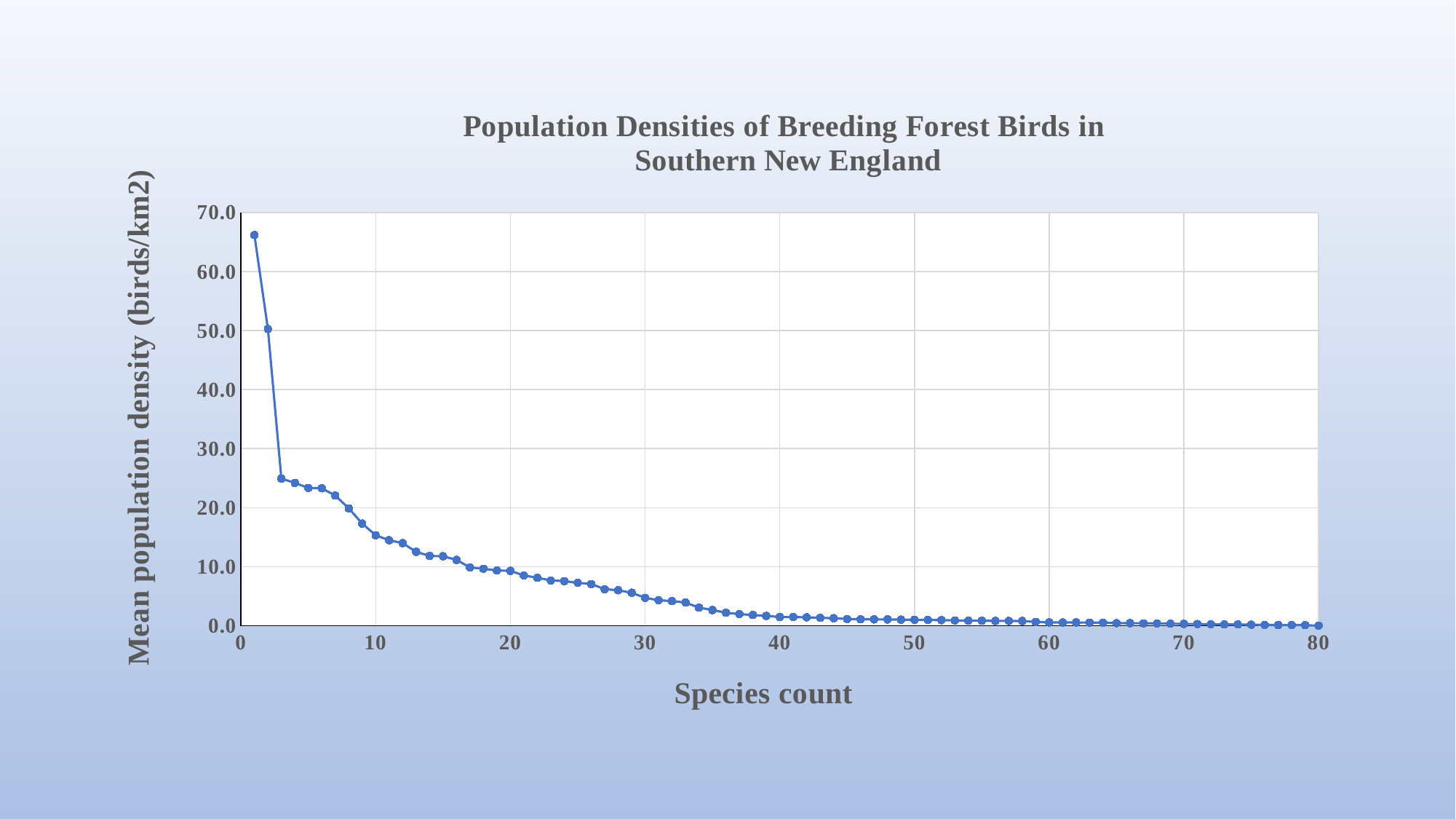
Is the mean population density at species count 3 greater or less than 20.0? greater Do the values rise or fall as species count increases along the x axis? fall What is the title of the chart? Population Densities of Breeding Forest Birds in Southern New England Is the mean population density at species count 10 greater or less than 10.0? greater How many data points are plotted on the chart? 80 At which species count is the mean population density highest? 1 Is the mean population density at species count 3 greater or less than 30.0? less What is the label of the y axis? Mean population density (birds/km2) Which has the larger mean population density, species count 2 or species count 20? species count 2 What kind of chart is shown on the slide? line chart